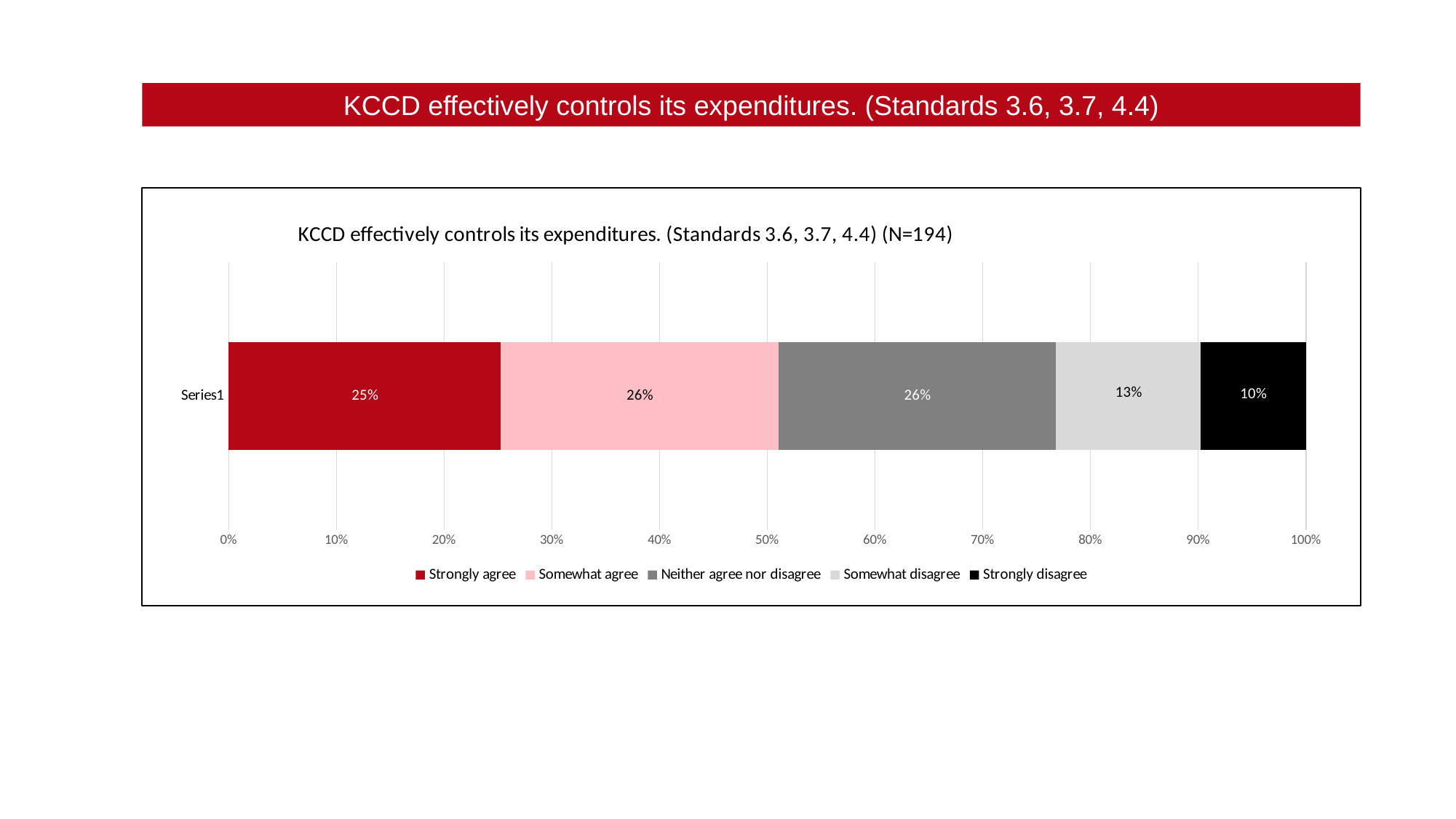
What percentage of respondents selected "Somewhat agree"? 26% How many series does the legend list? 5 What is the sample size (N) given in the chart title? 194 Which response option has the smallest share? Strongly disagree What percentage of respondents selected "Strongly agree"? 25% What percentage of respondents selected "Somewhat disagree"? 13% What is the difference between the "Strongly agree" share and the "Strongly disagree" share? 15% What kind of chart is shown on the slide? Stacked bar chart What percentage of respondents selected "Strongly disagree"? 10% What percentage of respondents selected "Neither agree nor disagree"? 26% Which is larger, the share for "Strongly agree" or the share for "Strongly disagree"? Strongly agree What is the total of all segments in the stacked bar? 100%